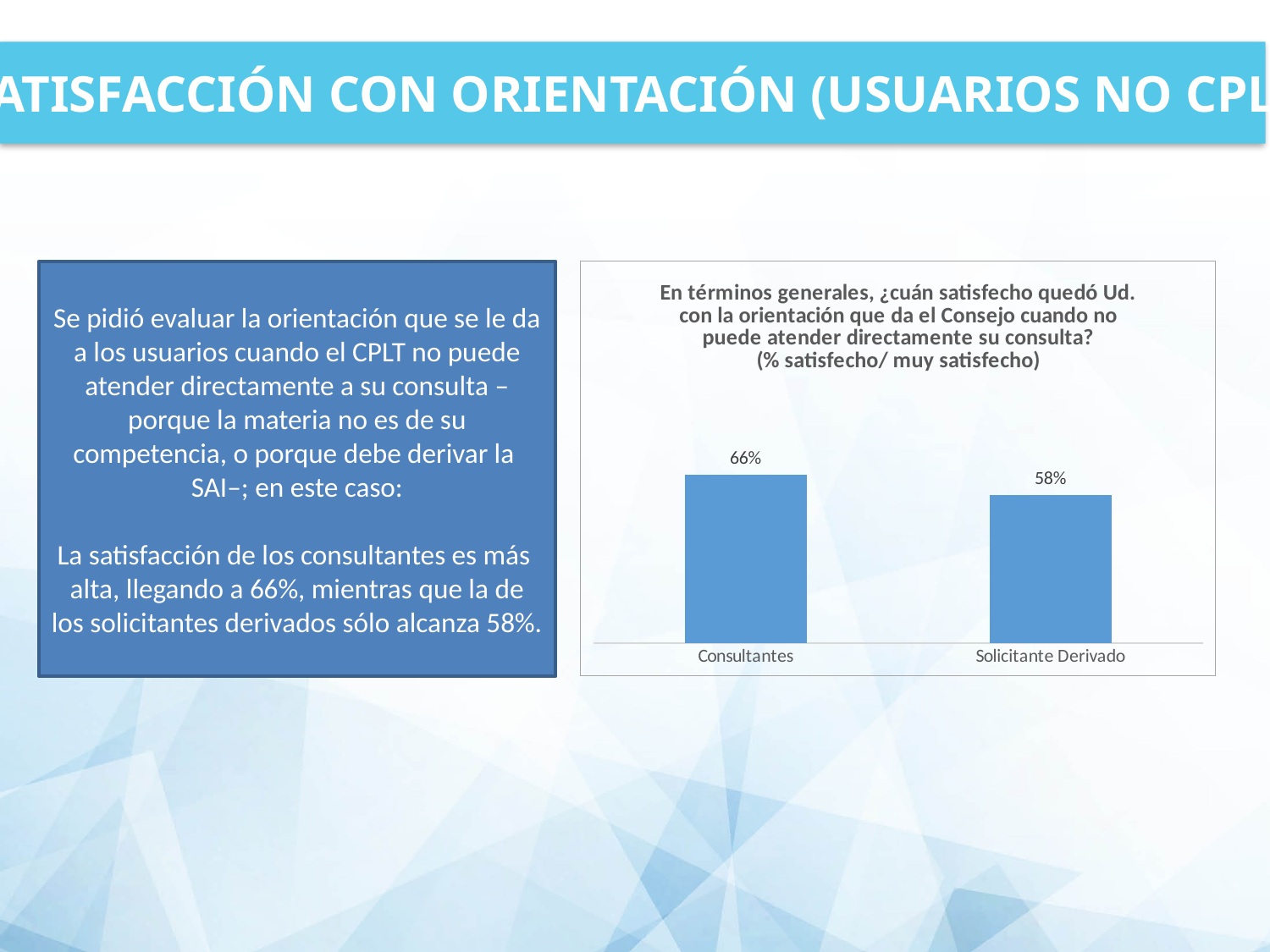
Which category has the highest value? Consultantes Which category has the lowest value? Solicitante Derivado What colour are the bars in the chart? Blue Which is larger, the value for Consultantes or for Solicitante Derivado? Consultantes What is the value for Solicitante Derivado? 58% Do the values rise or fall from Consultantes to Solicitante Derivado? Fall What is the difference between the values for Consultantes and Solicitante Derivado? 8% What measure does the chart title say the percentages represent? % satisfecho/ muy satisfecho How many categories are shown in the chart? 2 What kind of chart is shown on the slide? Bar chart What is the value for Consultantes? 66%